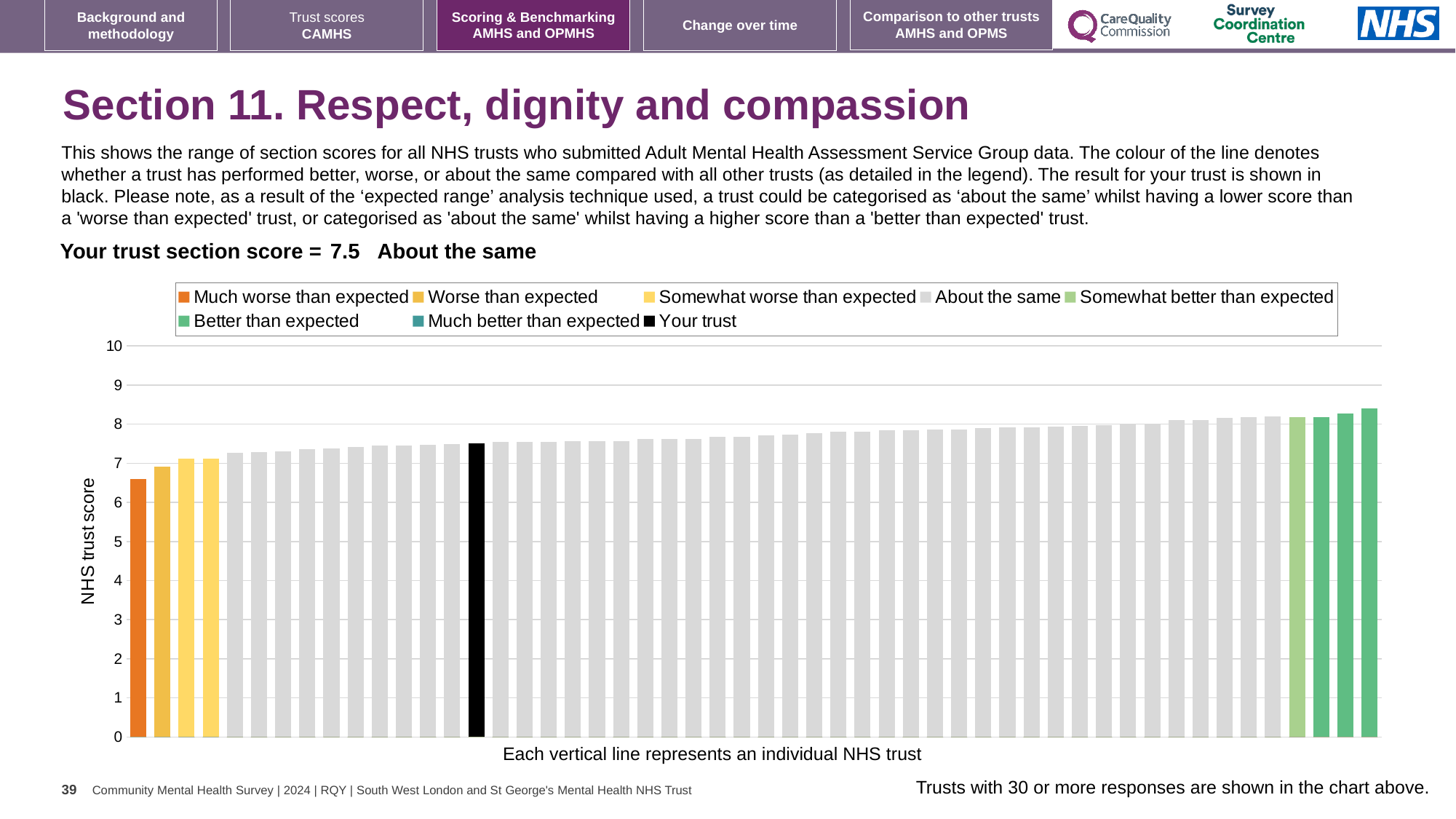
How many bars are coloured orange for 'Much worse than expected'? 1 Is the value of the leftmost (orange) bar greater or less than 7? less Is the value of the rightmost bar greater or less than 8? greater According to the caption below the chart, what does each vertical line represent? An individual NHS trust Is the value of the black 'Your trust' bar greater or less than 7? greater Which legend category does the tallest bar belong to? Better than expected What kind of chart is shown on the slide? Bar chart How many entries does the chart legend list? 8 Which is larger: the black 'Your trust' bar or the orange 'Much worse than expected' bar? The black 'Your trust' bar What is the label on the vertical axis of the chart? NHS trust score Do the bar values rise or fall from left to right along the x axis? Rise What is the section score for your trust shown on the slide? 7.5